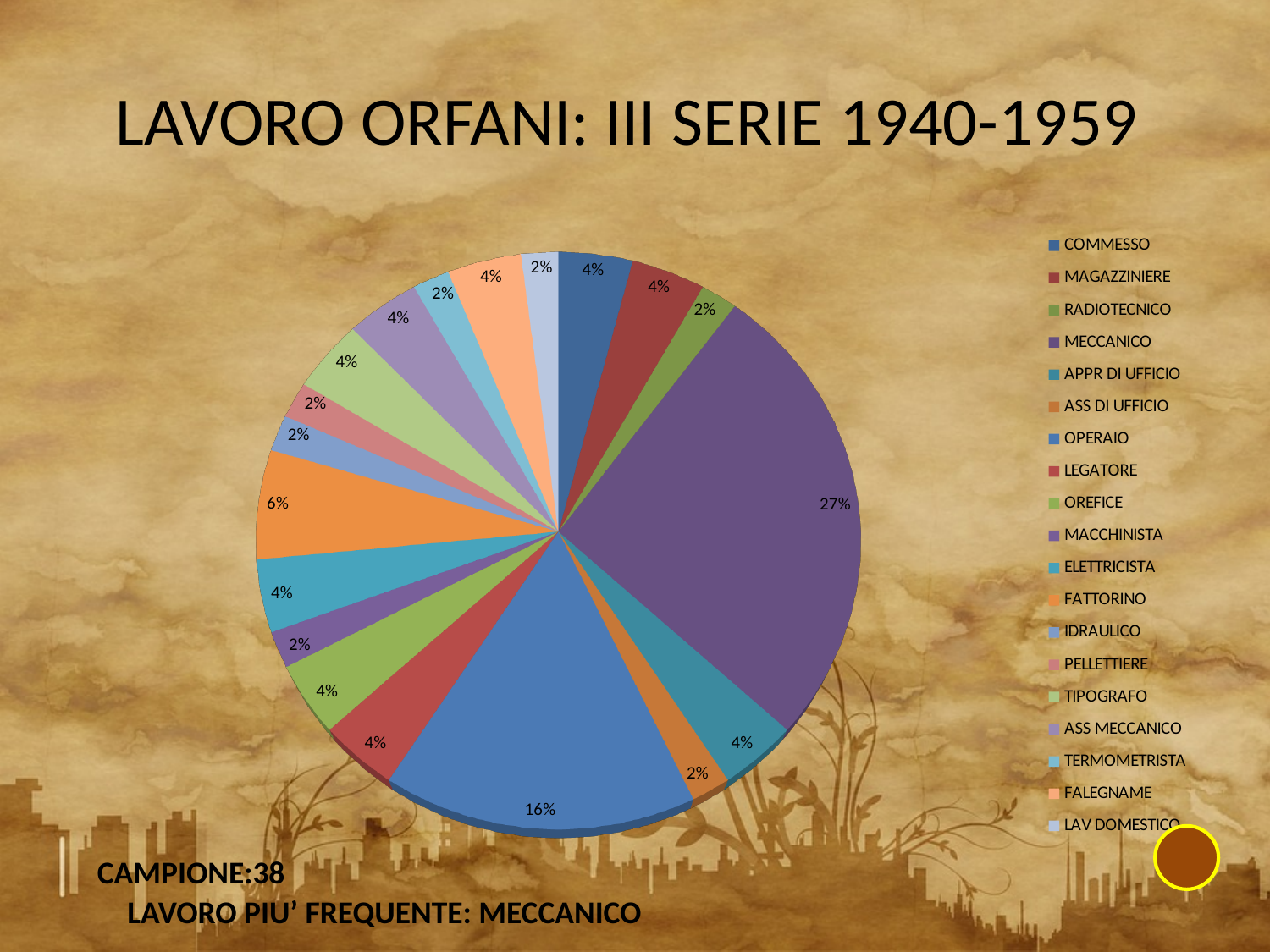
Which slice is larger, FATTORINO or COMMESSO? FATTORINO What is the title of the chart on the slide? LAVORO ORFANI: III SERIE 1940-1959 How many categories does the legend list? 19 What percentage of the pie does OPERAIO represent? 16% Which category has the largest slice of the pie? MECCANICO What is the difference in percentage points between the MECCANICO slice and the OPERAIO slice? 11 What percentage of the pie does FATTORINO represent? 6% What kind of chart is shown on the slide? pie chart Which slice is larger, OPERAIO or FATTORINO? OPERAIO What is the sample size (CAMPIONE) stated on the slide? 38 What percentage of the pie does COMMESSO represent? 4%